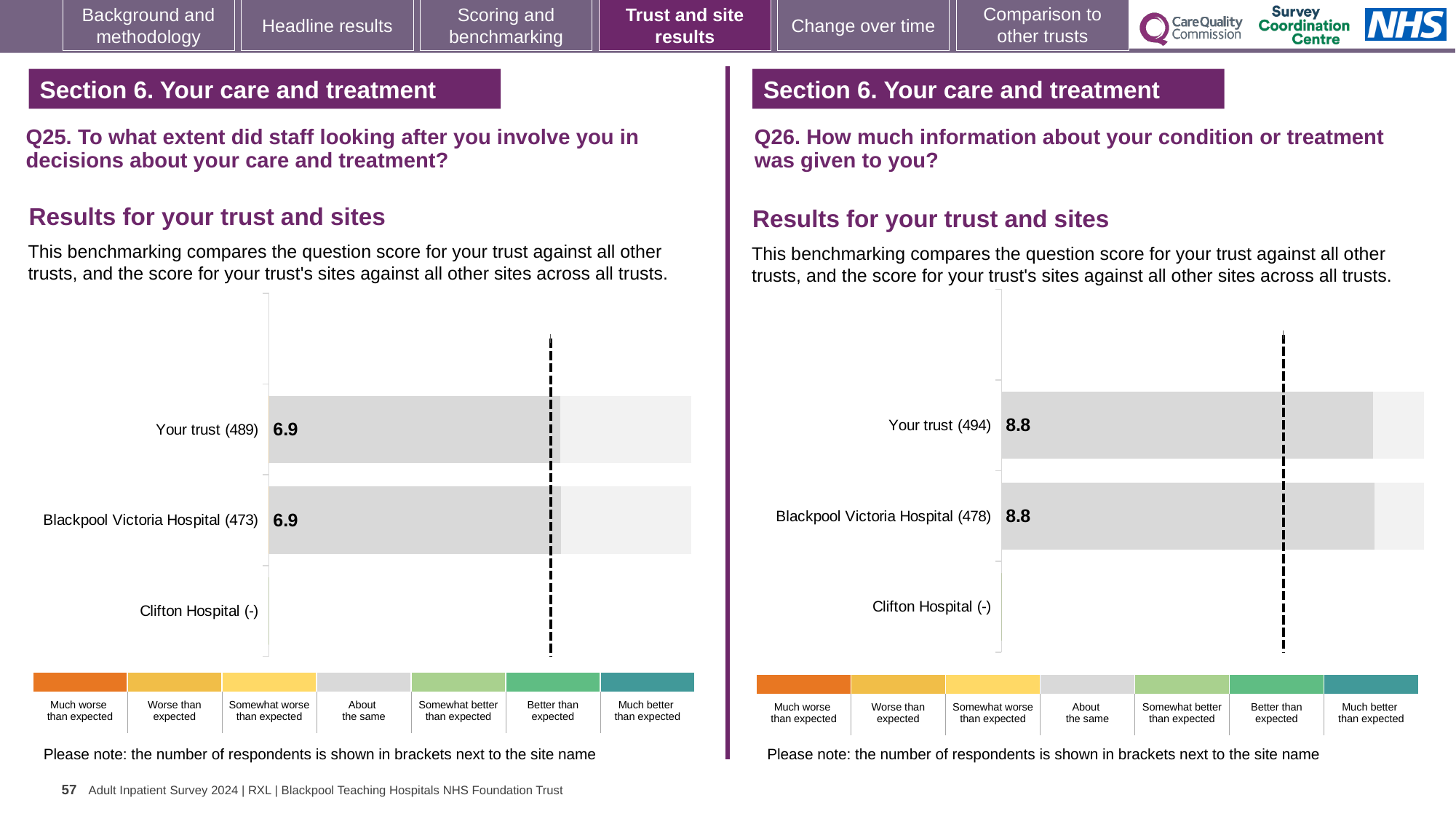
In the Q26 chart on the right, what is the score for Blackpool Victoria Hospital? 8.8 In the Q25 chart on the left, how many respondents are shown in brackets for Your trust? 489 In the Q25 chart on the left, what is the score for Blackpool Victoria Hospital? 6.9 How many site/trust categories are listed on the y axis of the Q25 chart on the left? 3 What is the difference between the Your trust score in the Q26 chart and the Your trust score in the Q25 chart? 1.9 In the Q25 chart on the left, what is the score for Your trust? 6.9 What kind of chart is used for the Q26 results on the right? Bar chart How many benchmark categories does the colour key below the Q25 chart list? 7 In the Q26 chart on the right, how many respondents are shown in brackets for Blackpool Victoria Hospital? 478 In the Q25 chart on the left, what is shown for Clifton Hospital? (-) Which is larger: the Your trust score in the Q26 chart on the right or the Your trust score in the Q25 chart on the left? Q26 chart (8.8) In the Q26 chart on the right, what is the score for Your trust? 8.8